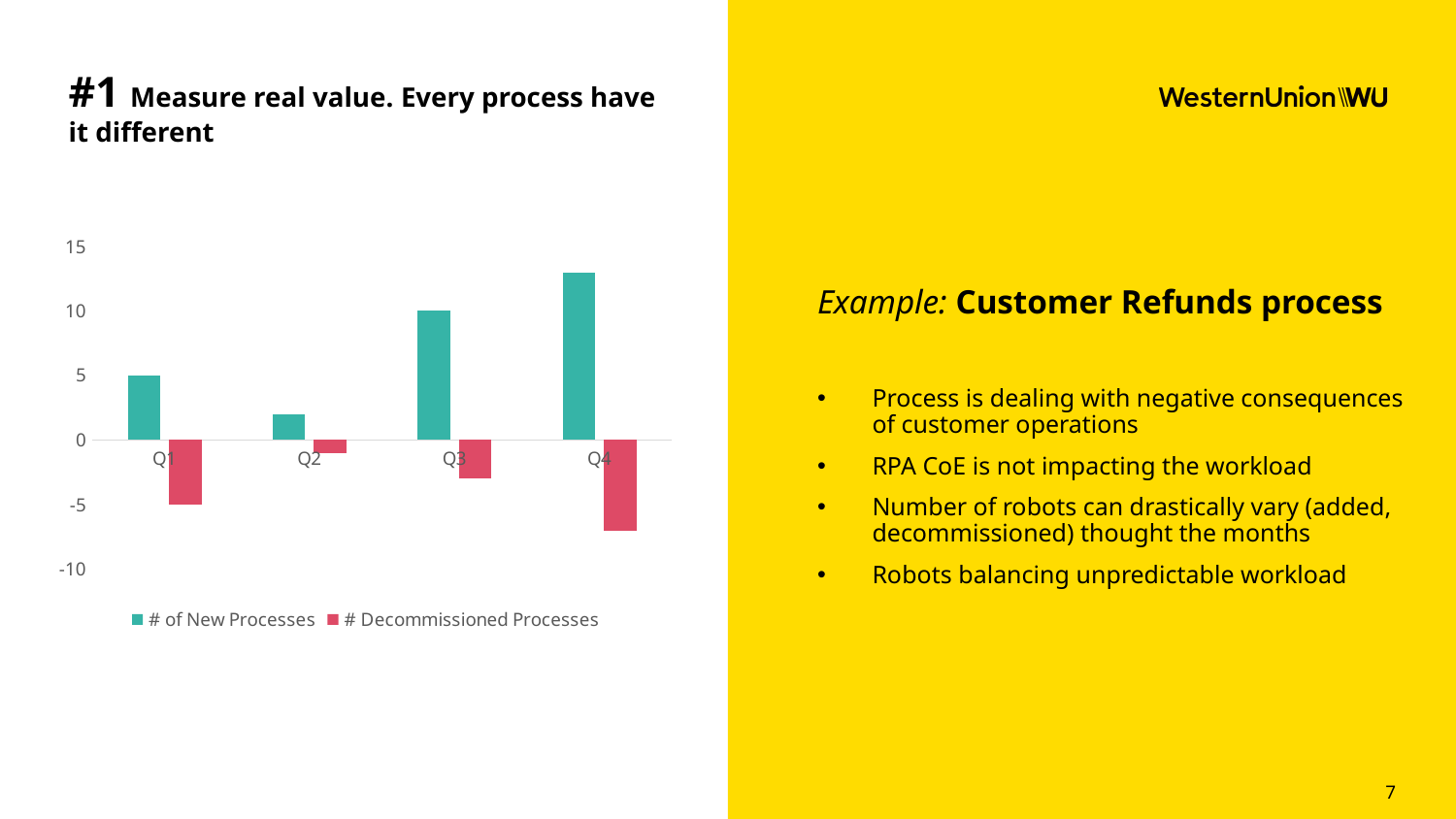
Is the value of # of New Processes for Q2 greater or less than 5? less Is the value of # of New Processes for Q4 greater or less than 10? greater Which quarter has the lowest # of New Processes? Q2 Which colour represents # of Decommissioned Processes in the chart? red Which quarter has the highest # of New Processes? Q4 Which quarter has a larger # of New Processes, Q1 or Q3? Q3 What type of chart is shown on the slide? bar chart What is the value of # of New Processes for Q3? 10 What is the value of # of Decommissioned Processes for Q1? -5 What is the value of # of New Processes for Q1? 5 How many series does the chart legend list? 2 How many quarters are shown on the x axis of the chart? 4